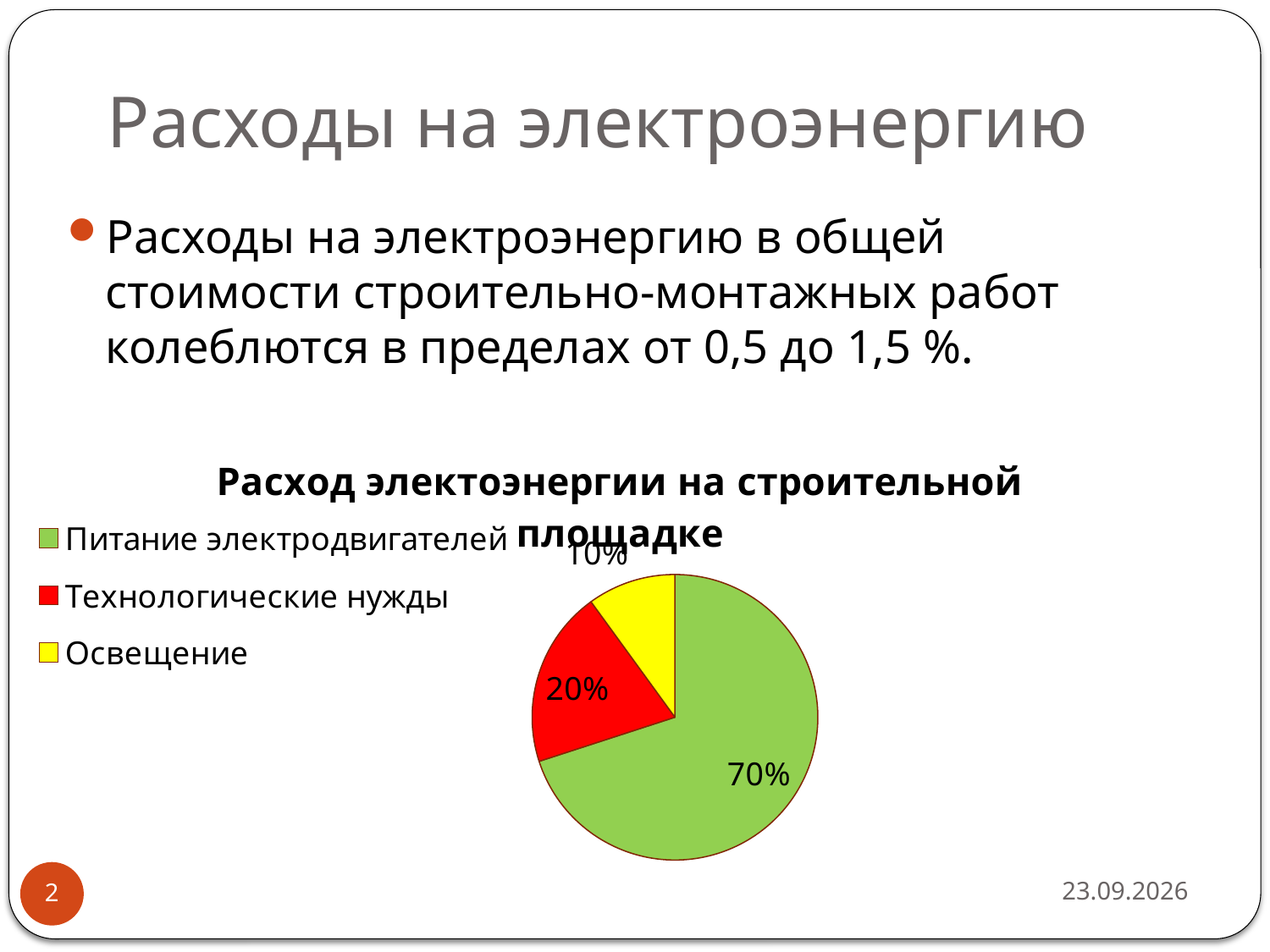
What is the difference in percentage points between Технологические нужды and Освещение? 10 Which category has the smallest slice of the pie? Освещение What share of the pie does Питание электродвигателей take? 70% Which is larger, the slice for Технологические нужды or the slice for Освещение? Технологические нужды What is the title of the chart? Расход электоэнергии на строительной площадке How many categories are shown in the pie chart? 3 What share of the pie does Технологические нужды take? 20% What share of the pie does Освещение take? 10% What kind of chart is shown on the slide? Pie chart What colour is the slice for Освещение? Yellow What is the difference in percentage points between Питание электродвигателей and Технологические нужды? 50 Which category has the largest slice of the pie? Питание электродвигателей